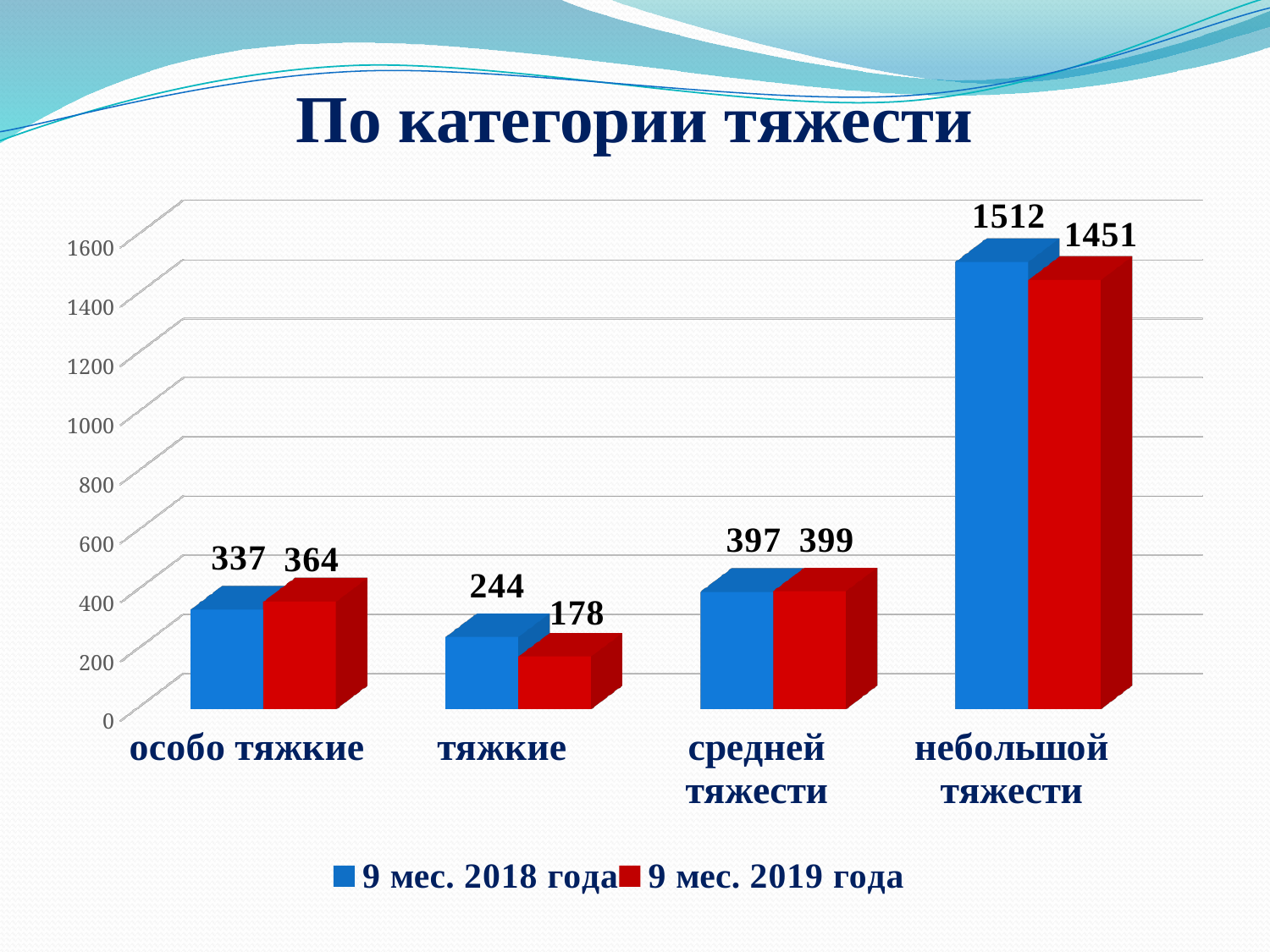
Which category has the highest value in the "9 мес. 2019 года" series? небольшой тяжести What is the difference between the "9 мес. 2018 года" and "9 мес. 2019 года" values for "небольшой тяжести"? 61 How many series does the legend list? 2 Which category has the lowest value in the "9 мес. 2018 года" series? тяжкие How many categories are shown on the x axis? 4 What kind of chart is shown on the slide? bar chart What is the value for "особо тяжкие" in the "9 мес. 2018 года" series? 337 What is the value for "тяжкие" in the "9 мес. 2019 года" series? 178 What is the difference between the "9 мес. 2018 года" and "9 мес. 2019 года" values for "тяжкие"? 66 Is the value for "средней тяжести" in the "9 мес. 2018 года" series greater or less than 400? less For "особо тяжкие", which series has the larger value: "9 мес. 2018 года" or "9 мес. 2019 года"? 9 мес. 2019 года What is the value for "небольшой тяжести" in the "9 мес. 2018 года" series? 1512